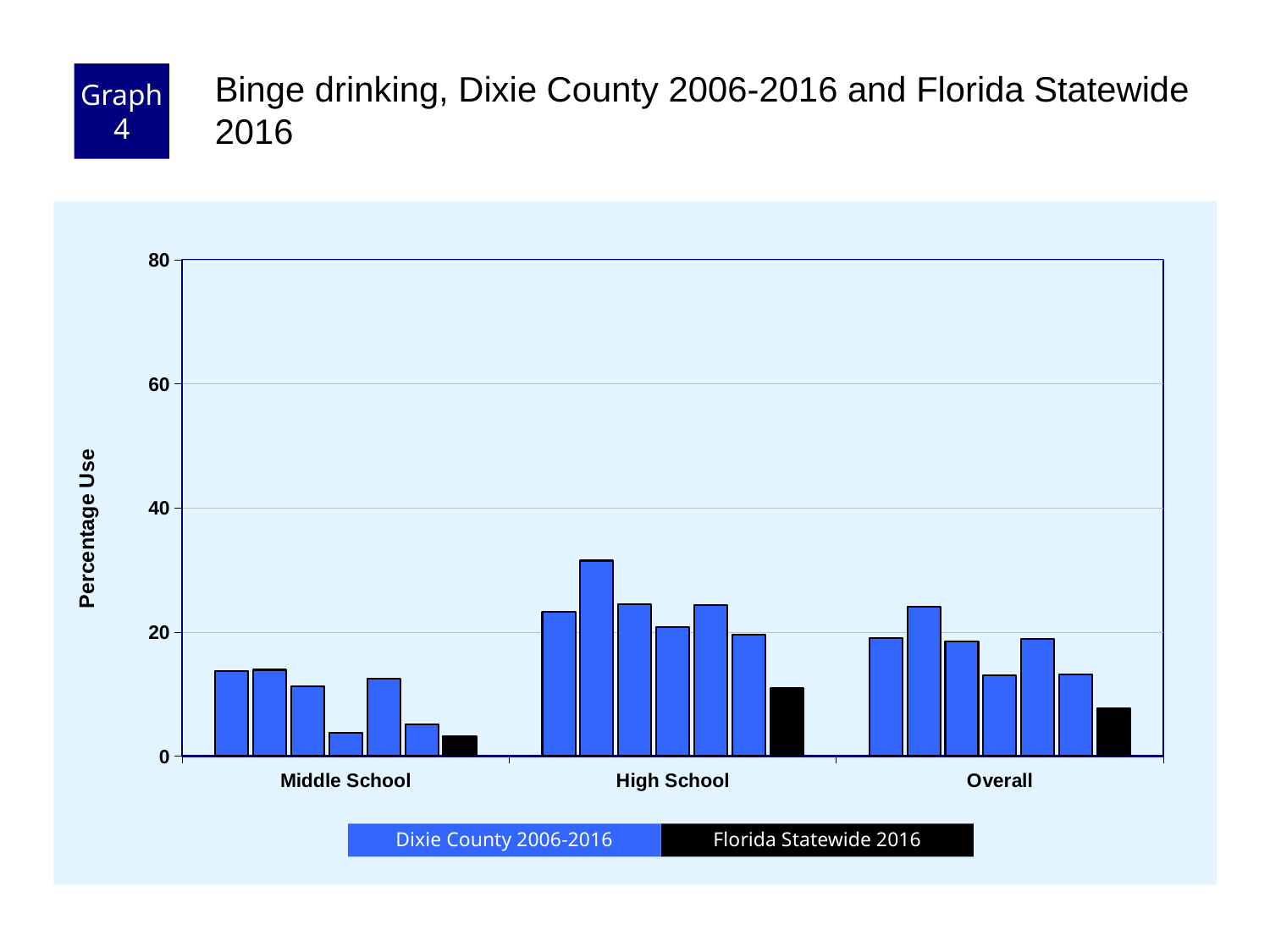
Which colour represents Florida Statewide 2016 in the legend? black Which category has the lowest Florida Statewide 2016 value? Middle School Is the Florida Statewide 2016 value for Middle School greater or less than 20? less Which category has the tallest bar in the chart? High School Which is larger, the Florida Statewide 2016 value for High School or for Overall? High School What kind of chart is shown on the slide? bar chart Are all the Middle School bars greater or less than 20? less How many series does the legend list? 2 Is the tallest Dixie County 2006-2016 bar for High School greater or less than 20? greater How many categories are shown on the x axis? 3 What is the title of the y axis? Percentage Use